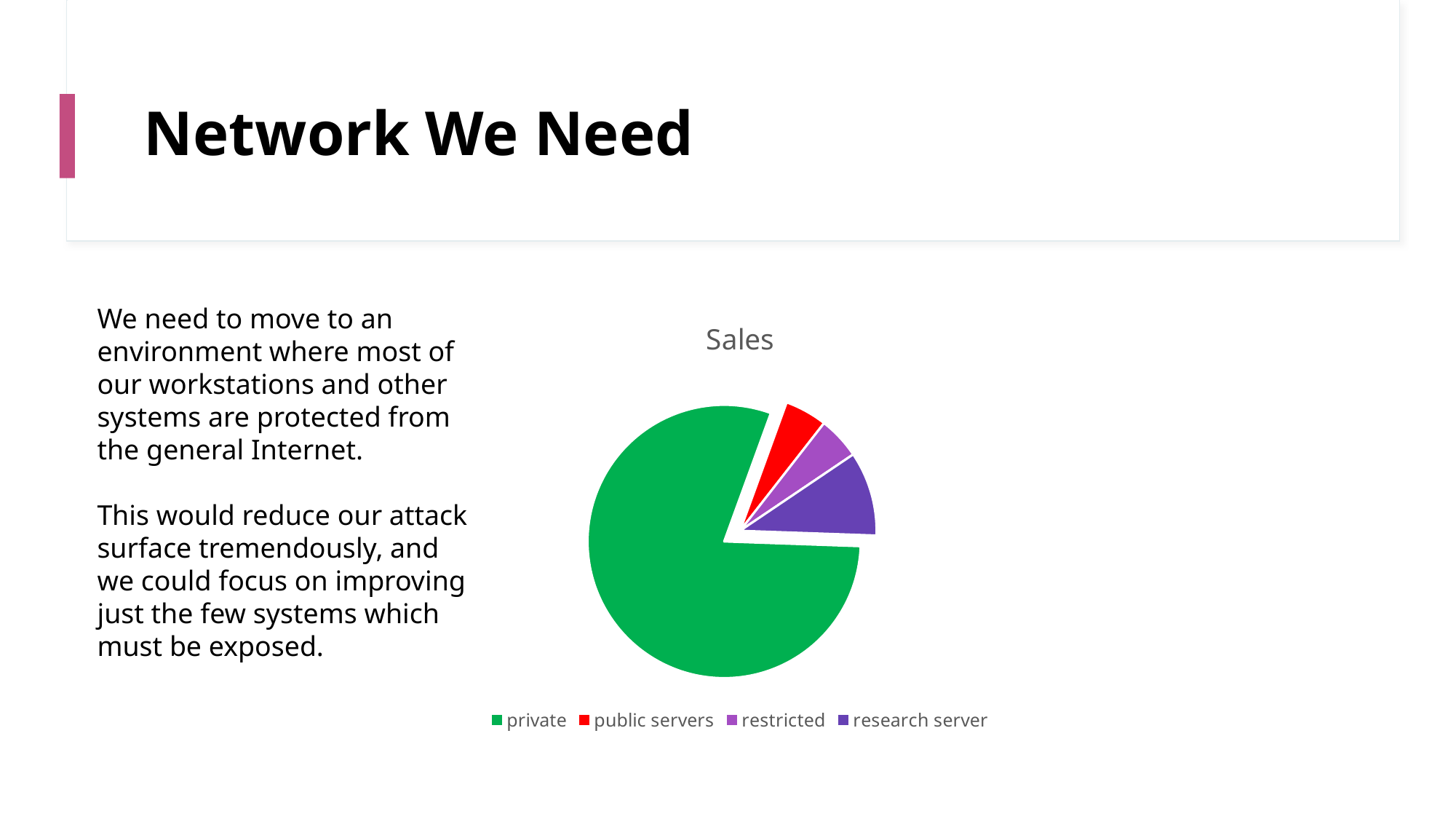
What kind of chart is shown on the slide? pie chart Which slice is larger, private or research server? private Which slice is larger, research server or public servers? research server Does the private slice take up more or less than half of the pie? more Which slice is larger, research server or restricted? research server What is the title of the chart? Sales What colour is the private slice in the pie chart? green Which category has the largest slice of the pie? private How many categories does the pie chart show? 4